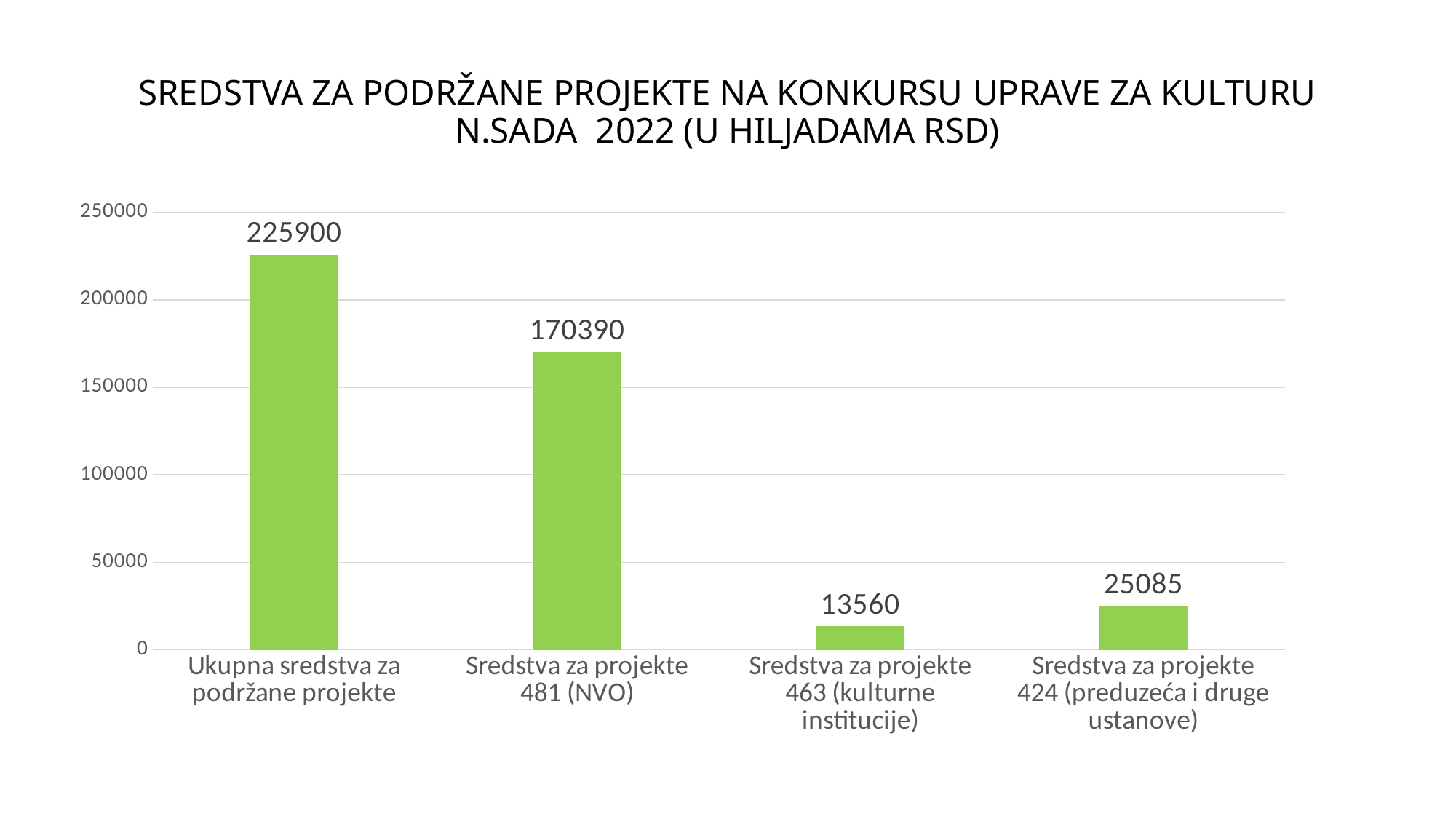
What is the value for 'Sredstva za projekte 481 (NVO)'? 170390 How many categories are shown in the chart? 4 What is the value for 'Sredstva za projekte 463 (kulturne institucije)'? 13560 What is the value for 'Sredstva za projekte 424 (preduzeća i druge ustanove)'? 25085 What kind of chart is shown on the slide? bar chart What is the value for 'Ukupna sredstva za podržane projekte'? 225900 What is the difference between the values for 'Ukupna sredstva za podržane projekte' and 'Sredstva za projekte 481 (NVO)'? 55510 Which category has the lowest value? Sredstva za projekte 463 (kulturne institucije) What is the difference between the values for 'Sredstva za projekte 424 (preduzeća i druge ustanove)' and 'Sredstva za projekte 463 (kulturne institucije)'? 11525 Is the value for 'Sredstva za projekte 481 (NVO)' greater or less than 150000? greater Which is larger: the value for 'Sredstva za projekte 463 (kulturne institucije)' or 'Sredstva za projekte 424 (preduzeća i druge ustanove)'? Sredstva za projekte 424 (preduzeća i druge ustanove) Which category has the highest value? Ukupna sredstva za podržane projekte